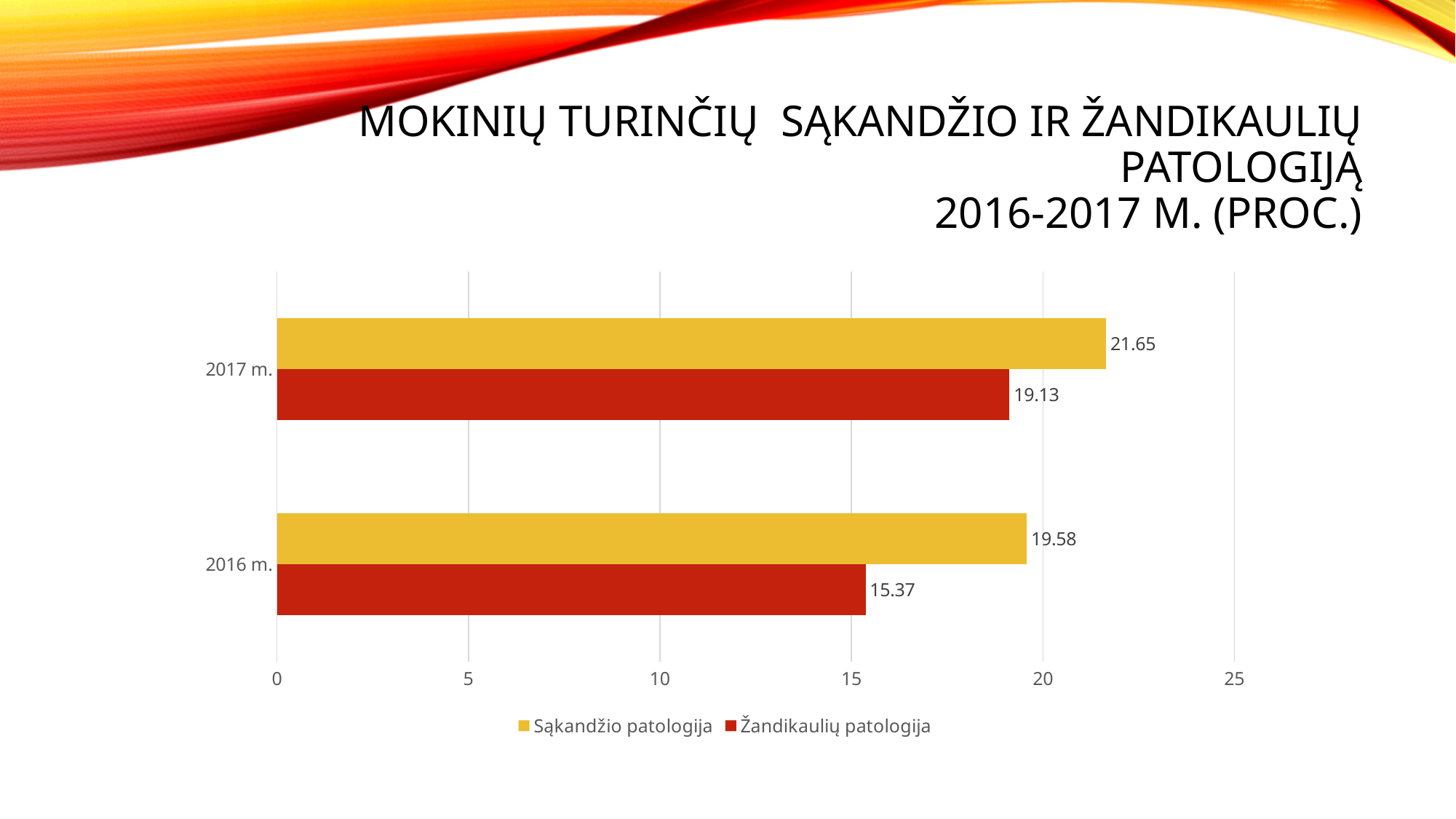
What is the difference between Sąkandžio patologija and Žandikaulių patologija in 2016 m.? 4.21 What kind of chart is shown on the slide? Bar chart What is the value for Sąkandžio patologija in 2016 m.? 19.58 Which year has the higher value for Žandikaulių patologija? 2017 m. Which bar has the lowest value on the chart? Žandikaulių patologija, 2016 m. What is the difference between the Sąkandžio patologija values for 2017 m. and 2016 m.? 2.07 Which colour represents Žandikaulių patologija in the legend? Red Which is larger in 2017 m.: Sąkandžio patologija or Žandikaulių patologija? Sąkandžio patologija What is the value for Žandikaulių patologija in 2017 m.? 19.13 What is the value for Sąkandžio patologija in 2017 m.? 21.65 How many series does the legend list? 2 What is the value for Žandikaulių patologija in 2016 m.? 15.37